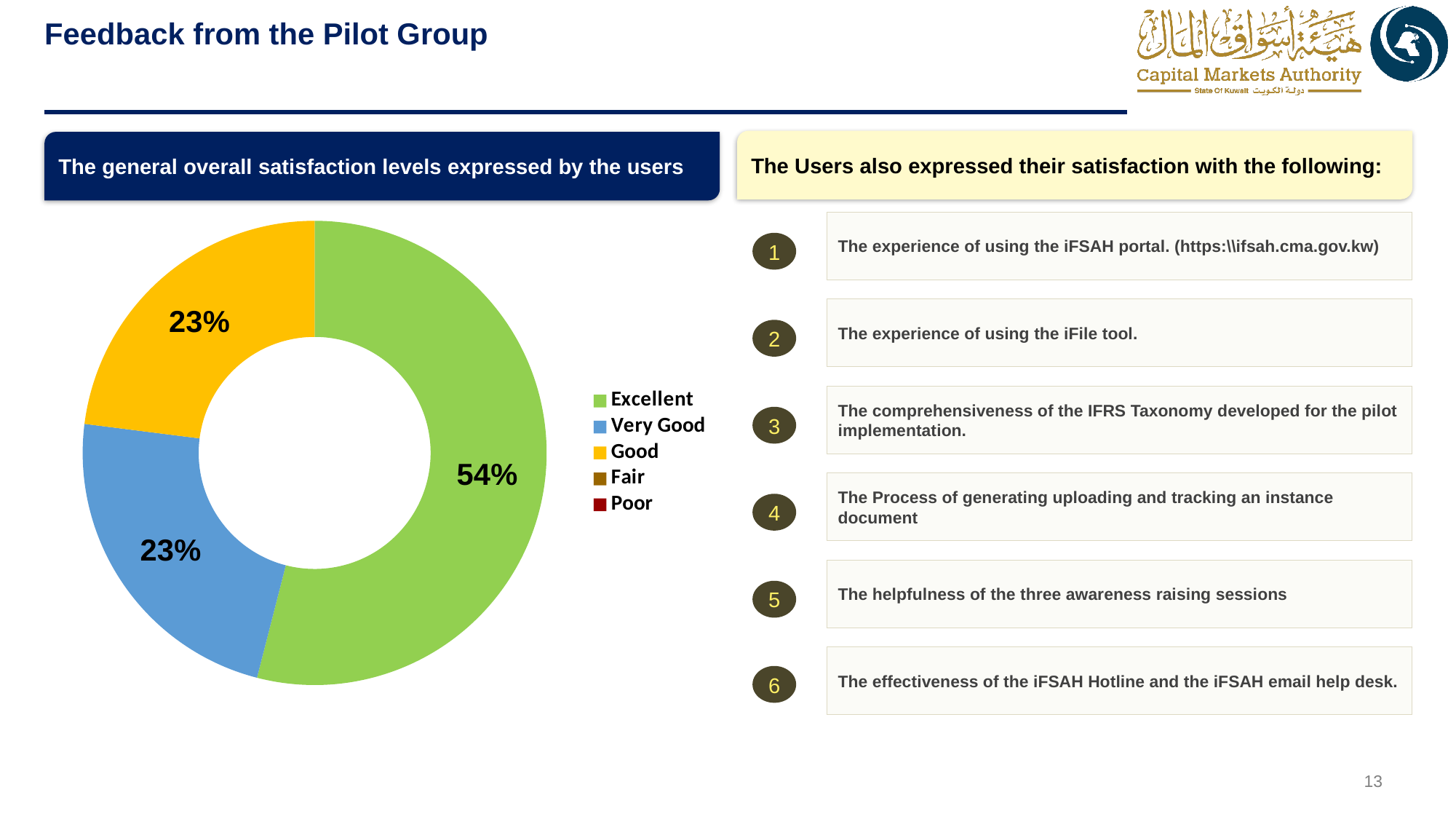
How many slices with a visible share are shown in the chart? 3 What kind of chart is used to show the overall satisfaction levels? doughnut chart Which satisfaction level has the largest share of the chart? Excellent How many satisfaction levels are listed in the chart's legend? 5 What colour represents the Excellent category in the chart? green By how many percentage points does the Excellent share exceed the Good share? 31 percentage points What percentage of users rated their overall satisfaction as Good? 23% What percentage of users rated their overall satisfaction as Very Good? 23% What is the combined share of Very Good and Good? 46% Which is larger, the share for Excellent or the share for Very Good? Excellent What percentage of users rated their overall satisfaction as Excellent? 54% What is the title shown above the satisfaction chart? The general overall satisfaction levels expressed by the users